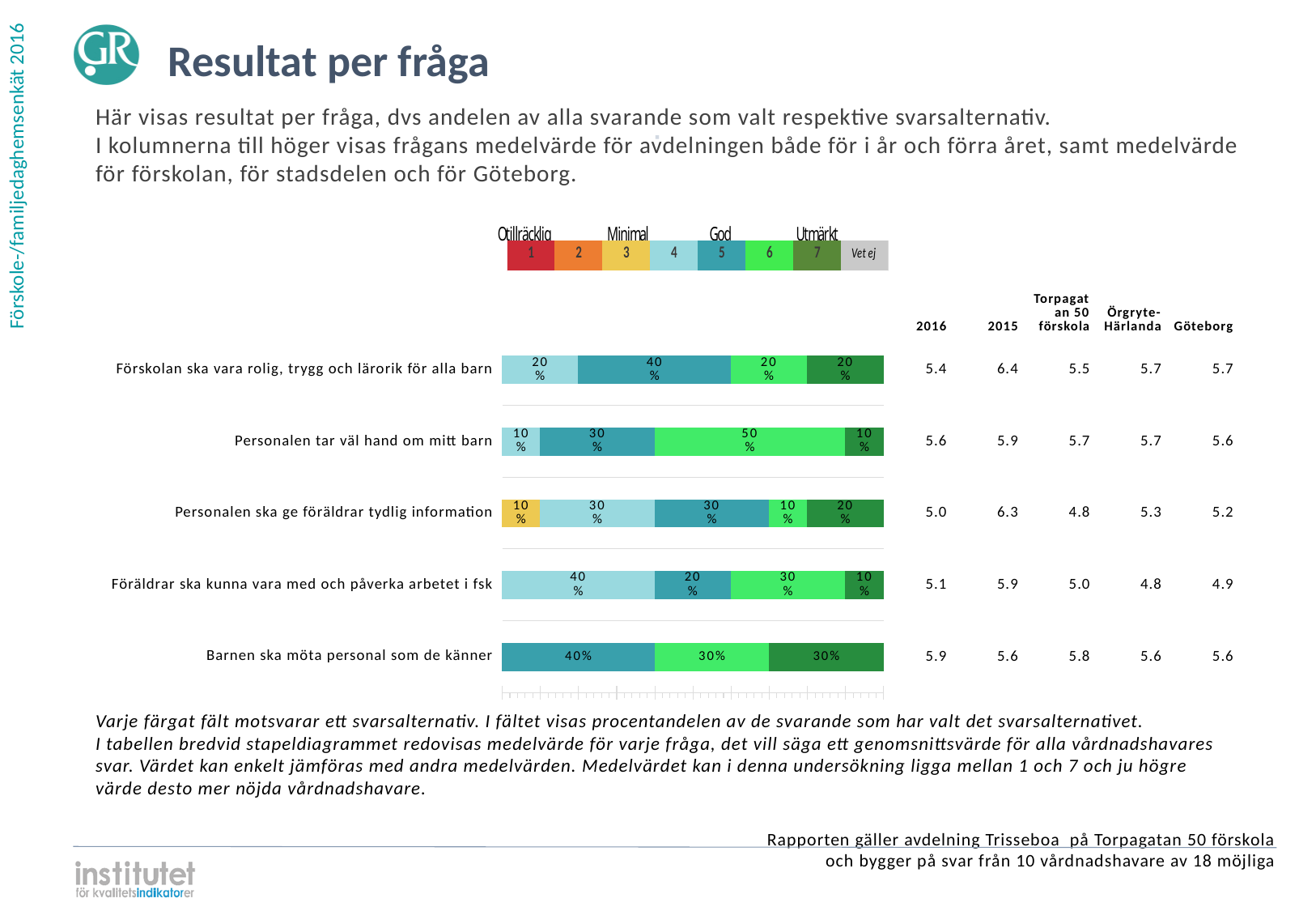
What percentage of respondents chose alternative 3 (yellow) for 'Personalen ska ge föräldrar tydlig information'? 10% What is the total of the segments in the bar for 'Förskolan ska vara rolig, trygg och lärorik för alla barn'? 100% What percentage of respondents chose alternative 6 (bright green) for 'Personalen tar väl hand om mitt barn'? 50% What is the difference between the alternative 5 share (40%) and the alternative 7 share (20%) for 'Förskolan ska vara rolig, trygg och lärorik för alla barn'? 20% How many questions (categories) are shown in the bar chart? 5 How many answer alternatives does the legend above the chart list? 8 What kind of chart is used to show the results per question? Stacked bar chart Which question has the largest single segment in its bar? Personalen tar väl hand om mitt barn What percentage of respondents chose alternative 7 (dark green) for 'Barnen ska möta personal som de känner'? 30% What percentage of respondents chose alternative 4 (light blue) for 'Föräldrar ska kunna vara med och påverka arbetet i fsk'? 40% What is the 2016 mean value shown for 'Barnen ska möta personal som de känner'? 5.9 For 'Personalen ska ge föräldrar tydlig information', which is larger: the share for alternative 4 or the share for alternative 6? Alternative 4